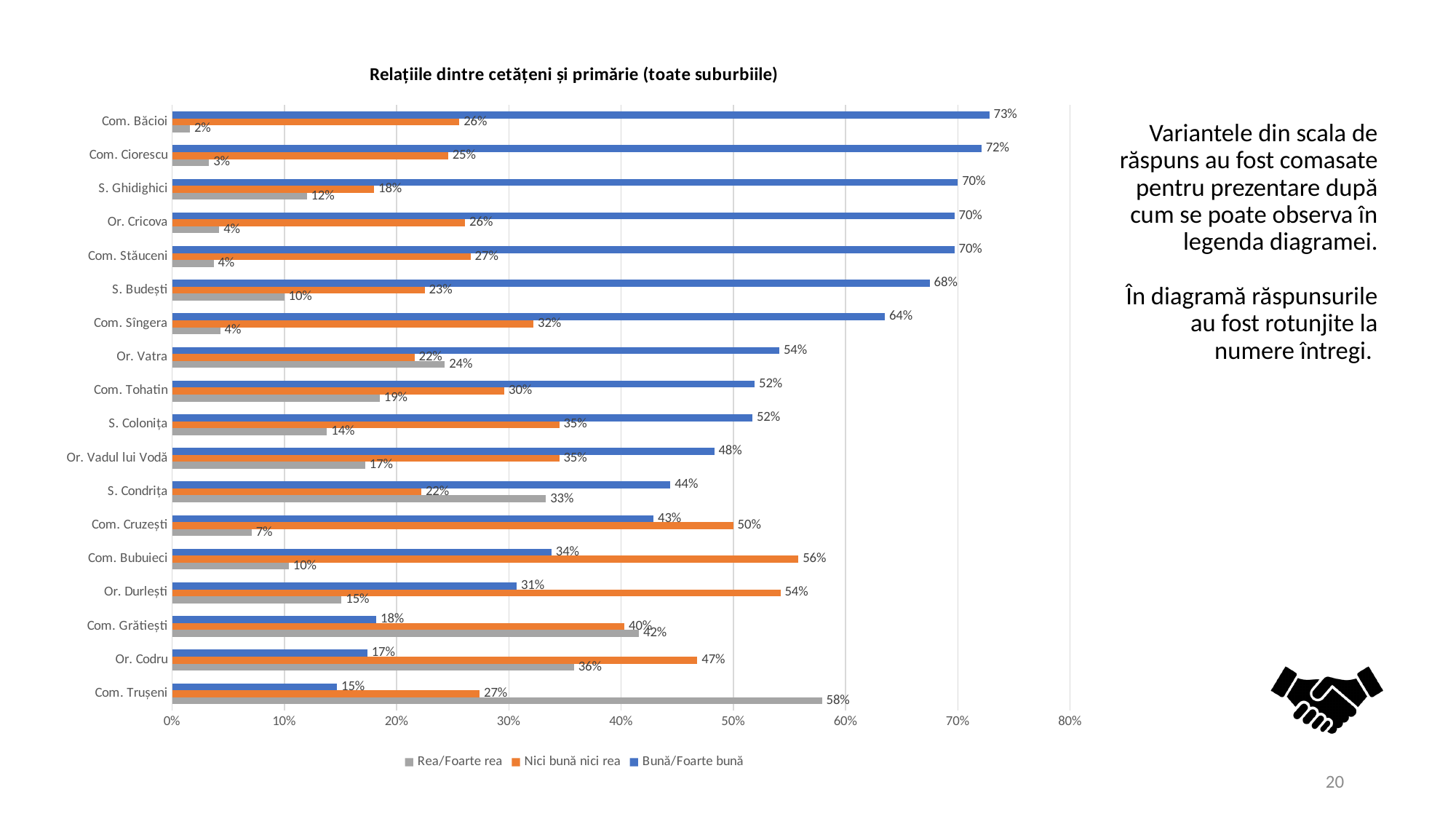
What is the Bună/Foarte bună value for Com. Băcioi? 73% What kind of chart is shown on the slide? Bar chart How many categories (localities) are shown on the chart? 18 Which category has the lowest Bună/Foarte bună value? Com. Trușeni What is the difference between the Bună/Foarte bună values for Com. Ciorescu and Or. Vatra? 18% Which colour represents the Nici bună nici rea series? Orange What is the Nici bună nici rea value for Com. Bubuieci? 56% How many series does the legend list? 3 Which is larger for Com. Cruzești: the Bună/Foarte bună value or the Nici bună nici rea value? Nici bună nici rea Which category has the highest Bună/Foarte bună value? Com. Băcioi What is the Rea/Foarte rea value for Com. Trușeni? 58% What is the title of the chart? Relațiile dintre cetățeni și primărie (toate suburbiile)